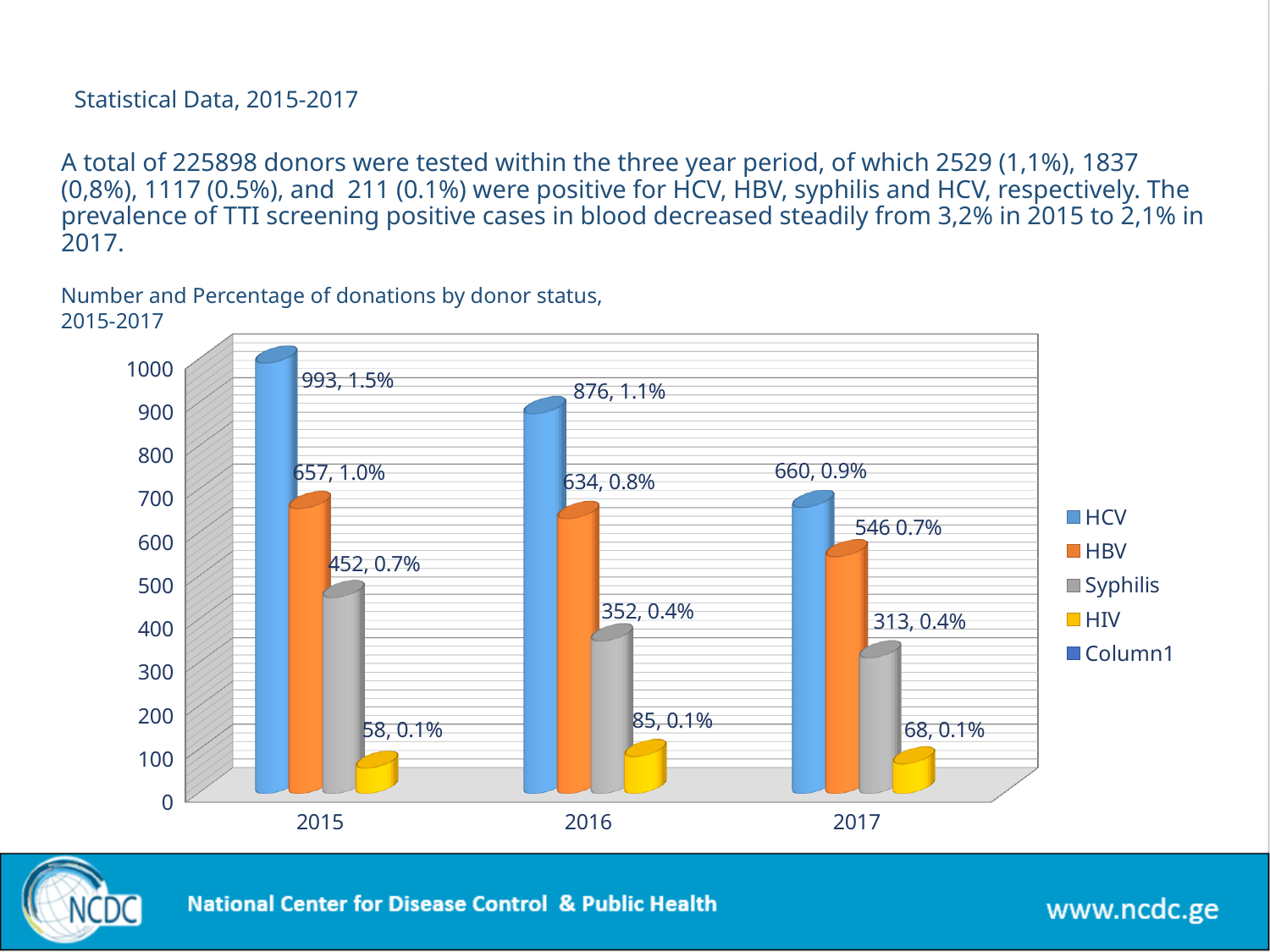
What is the data label for HBV in 2016? 634, 0.8% What is the data label for HIV in 2016? 85, 0.1% Which is larger, the HBV count in 2015 or the HBV count in 2017? HBV in 2015 What kind of chart is shown on the slide? Bar chart What is the data label for Syphilis in 2017? 313, 0.4% What is the data label for HCV in 2015? 993, 1.5% Do the HCV values rise or fall from 2015 to 2017? Fall How many years are shown on the x axis? 3 What is the difference between the HCV count in 2015 and the HCV count in 2017? 333 In which year is the HCV value highest? 2015 In which year is the HIV value lowest? 2015 How many series does the legend list? 5